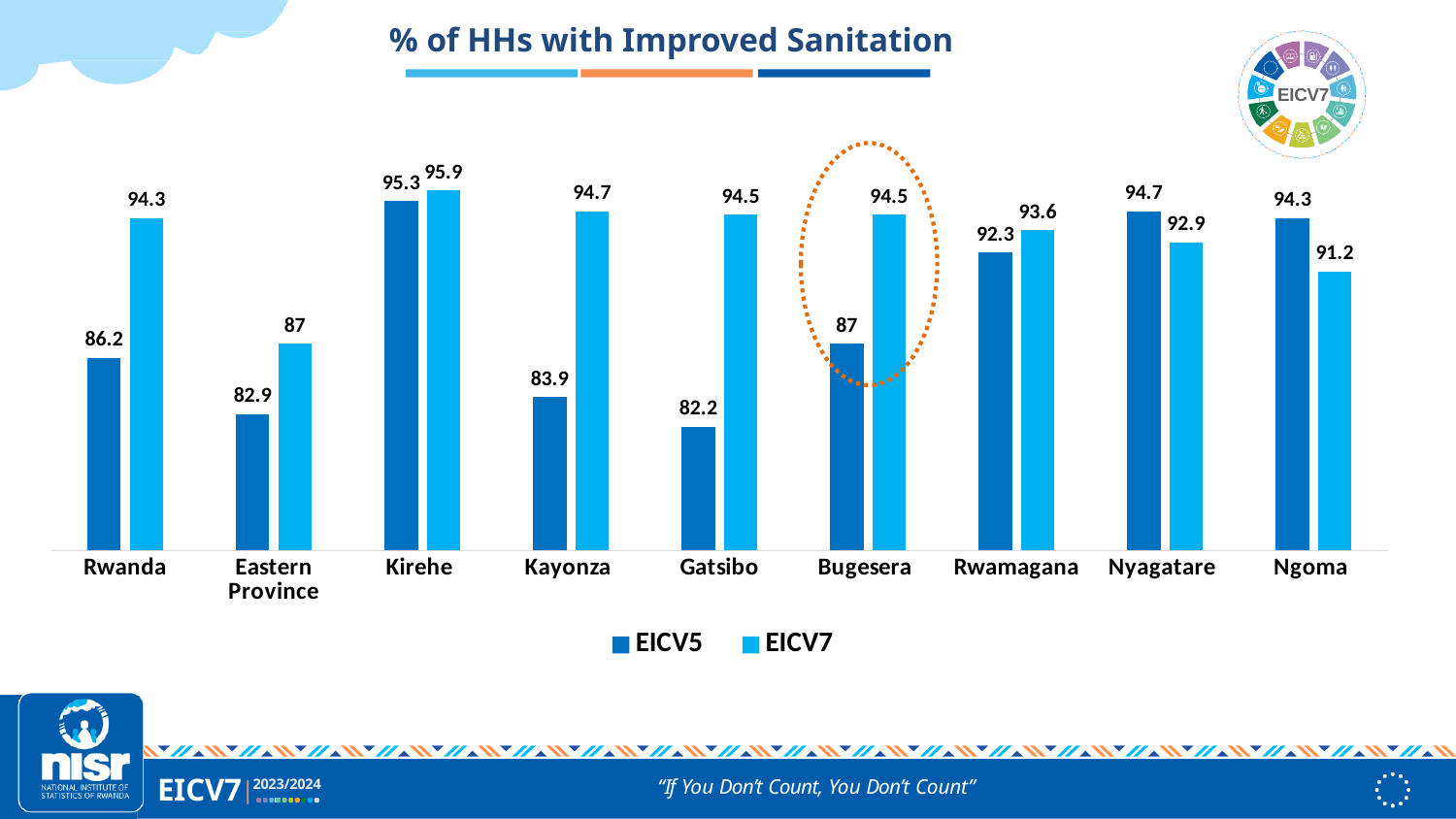
What kind of chart is shown on the slide? Bar chart What is the EICV5 value for Eastern Province? 82.9 How many categories are shown on the x axis? 9 What is the difference between the EICV7 and EICV5 values for Gatsibo? 12.3 What is the EICV7 value for Bugesera? 94.5 Which category has the lowest EICV5 value? Gatsibo How many series does the legend list? 2 Which category has the highest EICV7 value? Kirehe For Nyagatare, which is larger: the EICV5 value or the EICV7 value? EICV5 What is the EICV7 value for Rwanda? 94.3 Which category is highlighted with a dotted orange circle? Bugesera What is the title of the chart? % of HHs with Improved Sanitation